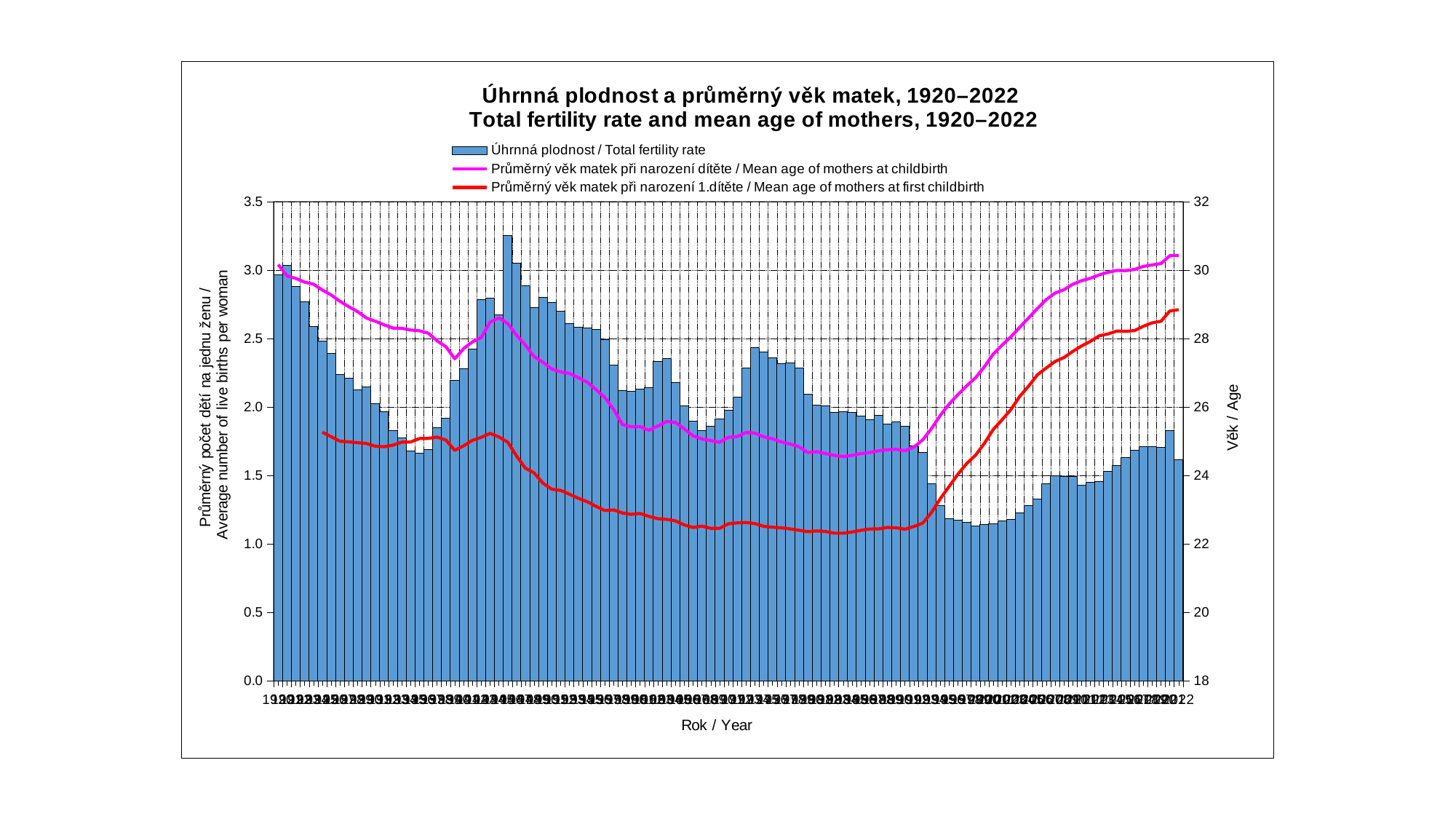
Which series is drawn as bars? Úhrnná plodnost / Total fertility rate Is the total fertility rate for 1920 greater or less than 2.5? greater Is the mean age of mothers at childbirth in 2022 greater or less than 30? greater What kind of chart is shown on the slide? A bar chart combined with two line series Is the mean age of mothers at first childbirth in 2022 greater or less than 28? greater Which year has the higher total fertility rate, 1920 or 2022? 1920 What colour is the line for the mean age of mothers at first childbirth? Red In 2022, which is higher: the mean age of mothers at childbirth or the mean age of mothers at first childbirth? Mean age of mothers at childbirth How many series does the legend list? 3